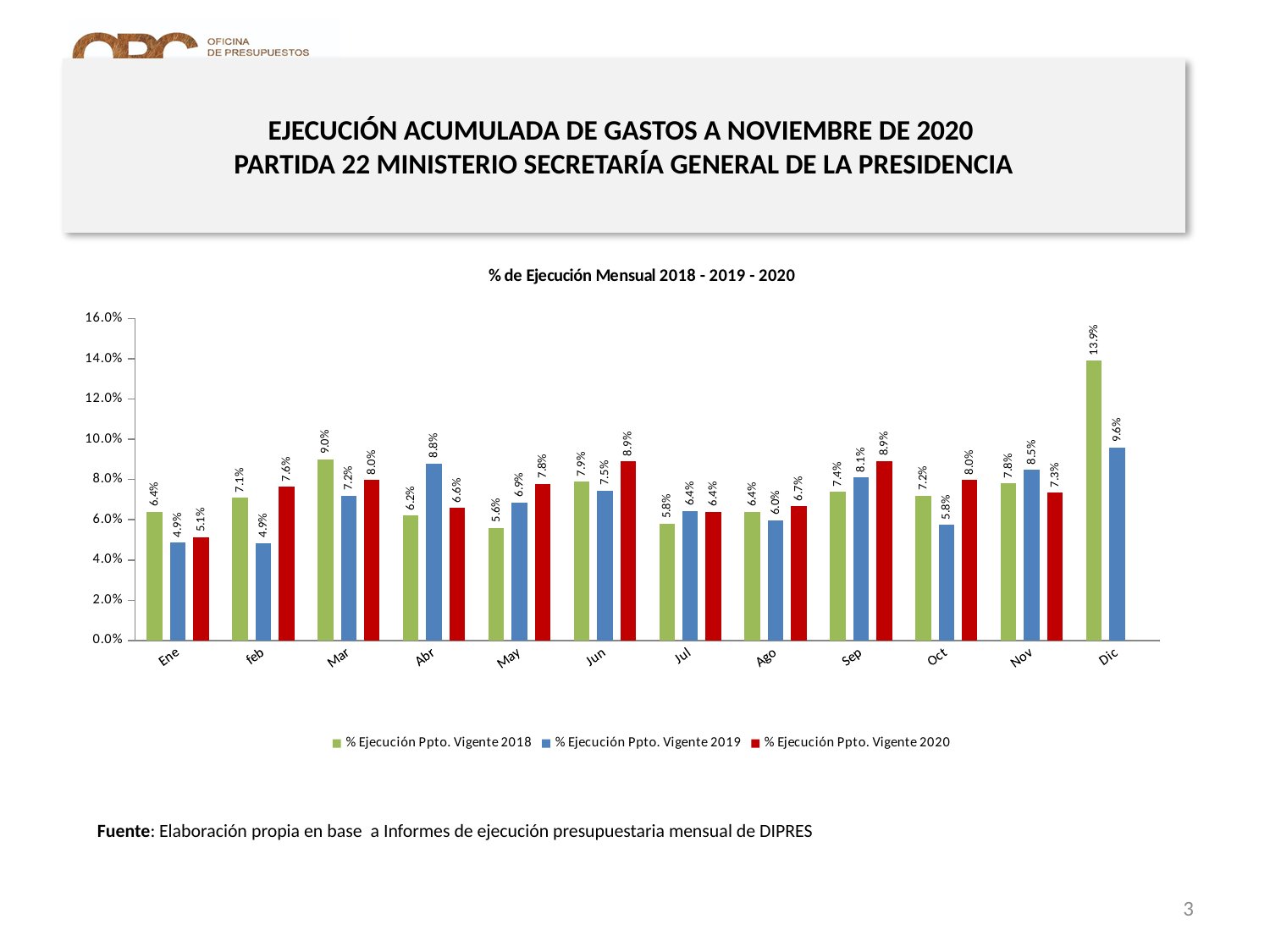
How many months are shown on the x axis? 12 Which month has the lowest value for % Ejecución Ppto. Vigente 2018? May How many series does the legend list? 3 What is the value for % Ejecución Ppto. Vigente 2018 in Dic? 13.9% What is the title of the chart? % de Ejecución Mensual 2018 - 2019 - 2020 Which month has the highest value for % Ejecución Ppto. Vigente 2019? Dic What is the difference between the 2018 and 2019 values in Dic? 4.3% What is the value for % Ejecución Ppto. Vigente 2019 in Abr? 8.8% Is the value for % Ejecución Ppto. Vigente 2018 in Mar greater or less than 8.0%? greater Which is larger in Oct: the value for % Ejecución Ppto. Vigente 2020 or for % Ejecución Ppto. Vigente 2019? % Ejecución Ppto. Vigente 2020 What kind of chart is shown on the slide? Bar chart What is the value for % Ejecución Ppto. Vigente 2020 in Jun? 8.9%